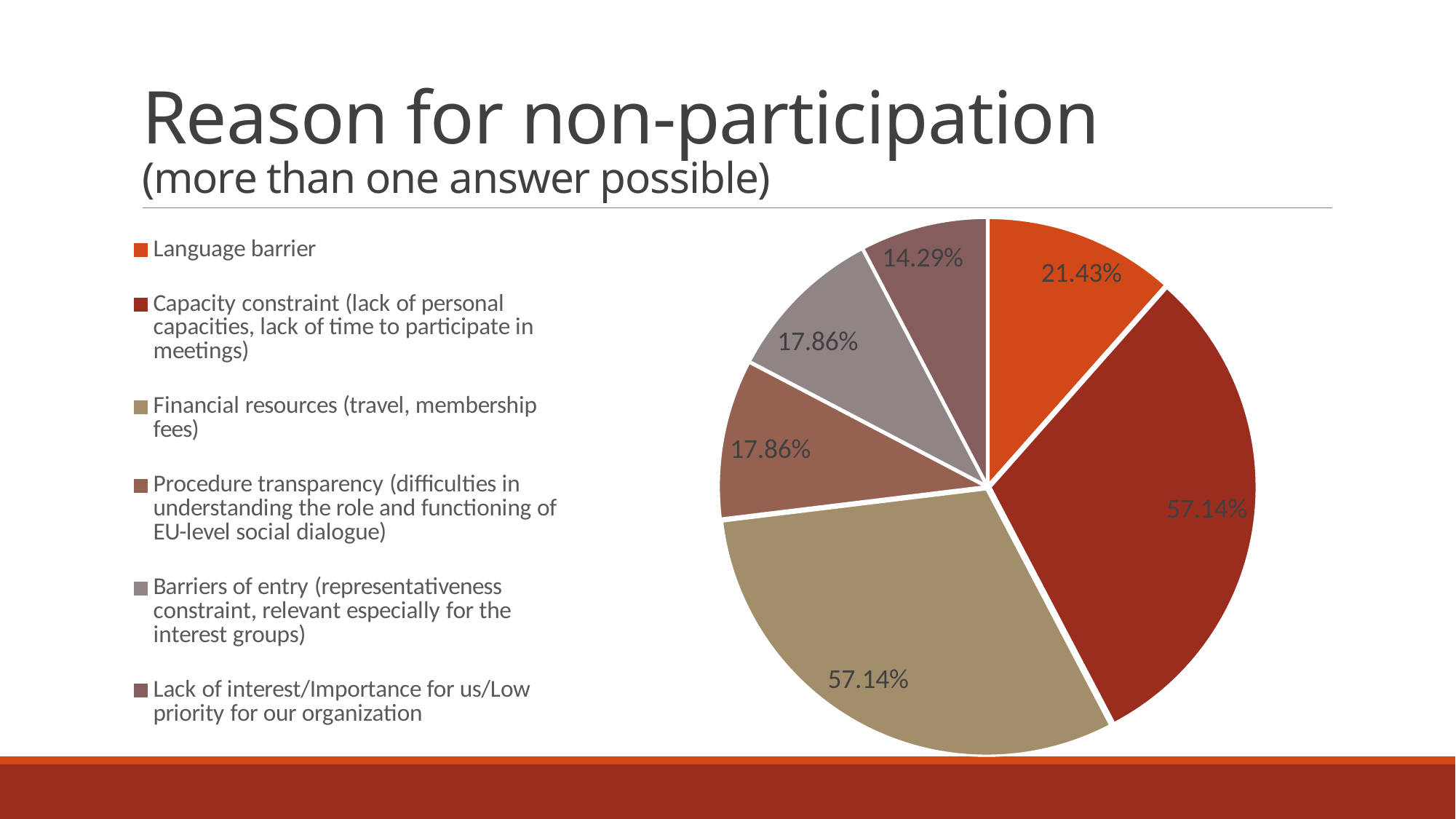
Which is larger: the value for Language barrier or the value for Lack of interest/Importance for us/Low priority for our organization? Language barrier What is the value shown for Lack of interest/Importance for us/Low priority for our organization? 14.29% What is the title of the slide containing the chart? Reason for non-participation How many categories (slices) does the pie chart have? 6 What is the difference between the value for Capacity constraint and the value for Language barrier? 35.71% Which reason has the smallest value in the pie chart? Lack of interest/Importance for us/Low priority for our organization What is the value shown for Procedure transparency? 17.86% What is the difference between the value for Language barrier and the value for Lack of interest/Importance for us/Low priority for our organization? 7.14% What kind of chart is shown on the slide? pie chart What is the value shown for Language barrier? 21.43% What is the value shown for Financial resources (travel, membership fees)? 57.14% What is the value shown for Capacity constraint (lack of personal capacities, lack of time to participate in meetings)? 57.14%